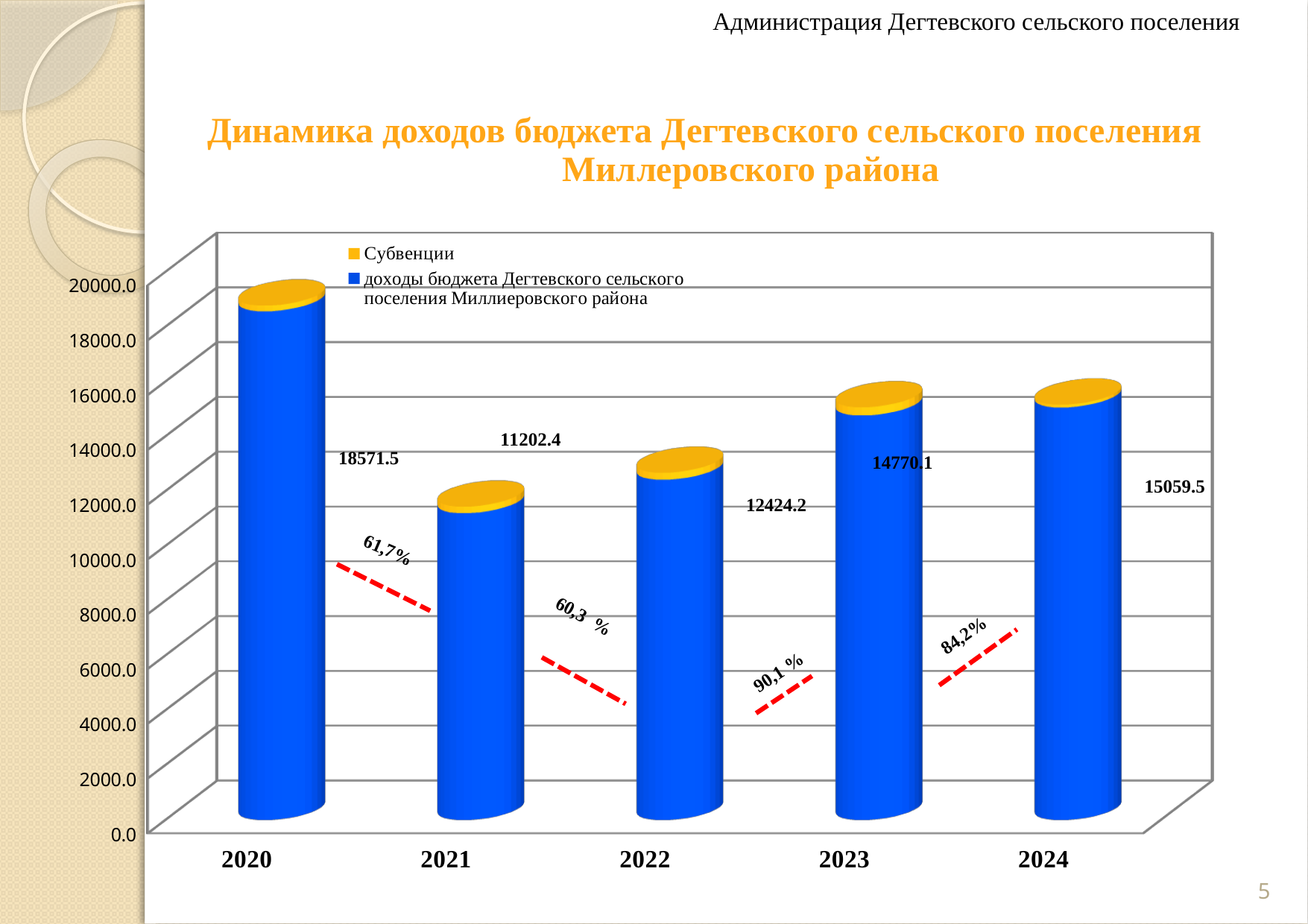
What value is labelled for 2024 on the chart? 15059.5 What value is labelled for 2021 on the chart? 11202.4 Which year has the highest labelled value on the chart? 2020 What value is labelled for 2023 on the chart? 14770.1 What is the difference between the labelled values for 2024 and 2023? 289.4 What percentage is written on the dashed line between 2020 and 2021? 61,7% Which year has the larger labelled value, 2022 or 2023? 2023 What value is labelled for 2020 on the chart? 18571.5 How many series does the chart legend list? 2 How many years are shown on the x axis of the chart? 5 Which year has the lowest labelled value on the chart? 2021 What kind of chart is shown on the slide? bar chart